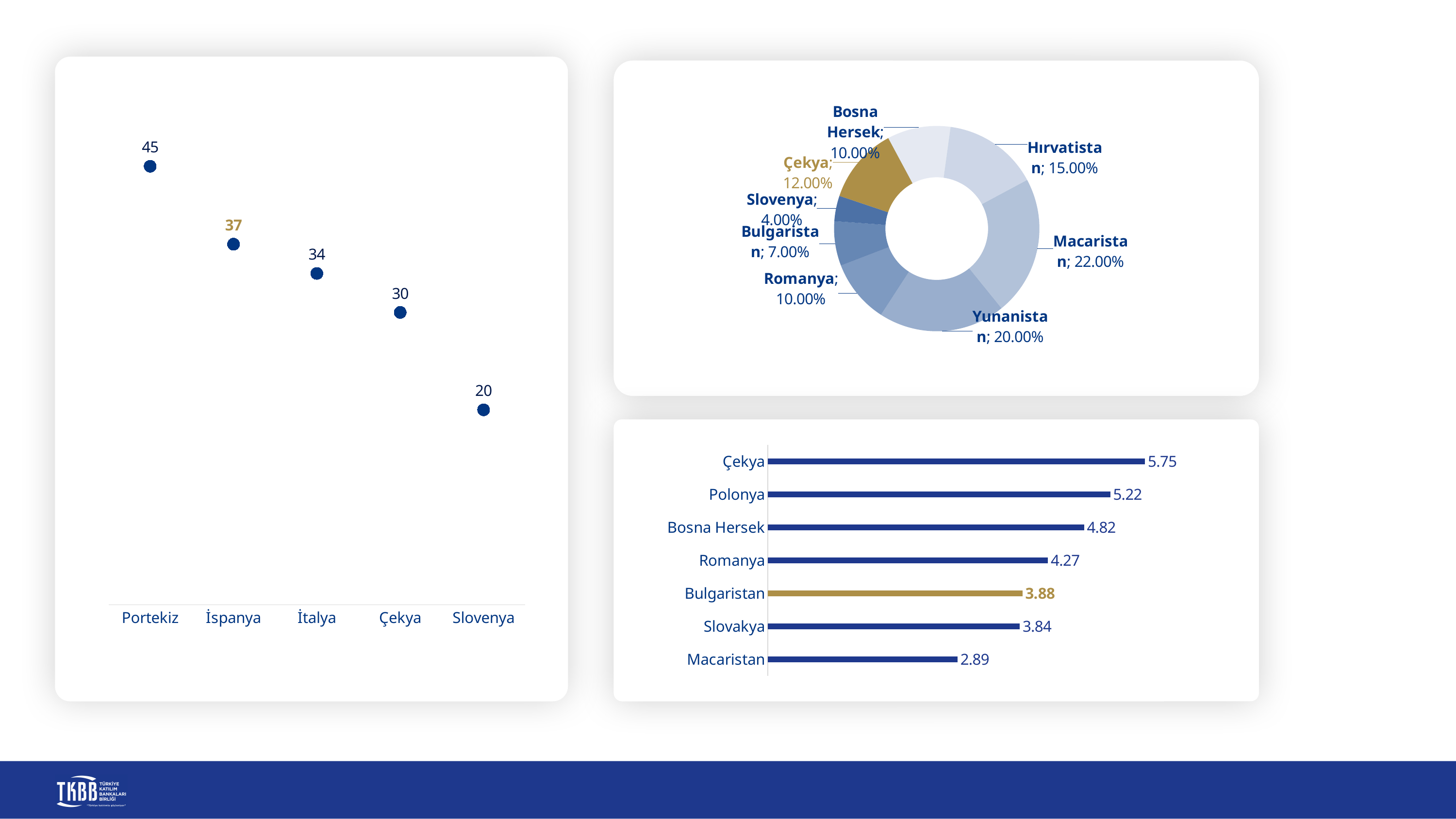
In the bar chart at the bottom right of the slide, what is the value for Bulgaristan? 3.88 In the doughnut chart at the top right of the slide, which slice is the smallest? Slovenya In the chart on the left of the slide, do the values rise or fall from Portekiz to Slovenya? fall In the doughnut chart at the top right of the slide, what share does Macaristan have? 22.00% In the doughnut chart at the top right of the slide, which is larger, Hırvatistan or Çekya? Hırvatistan In the doughnut chart at the top right of the slide, how many slices are there? 8 What kind of chart is shown at the bottom right of the slide? bar chart In the chart on the left of the slide, what is the value for Portekiz? 45 In the bar chart at the bottom right of the slide, which category has the highest value? Çekya In the chart on the left of the slide, what is the difference between the values for İspanya and Çekya? 7 In the chart on the left of the slide, which category has the lowest value? Slovenya In the chart on the left of the slide, how many categories are plotted? 5